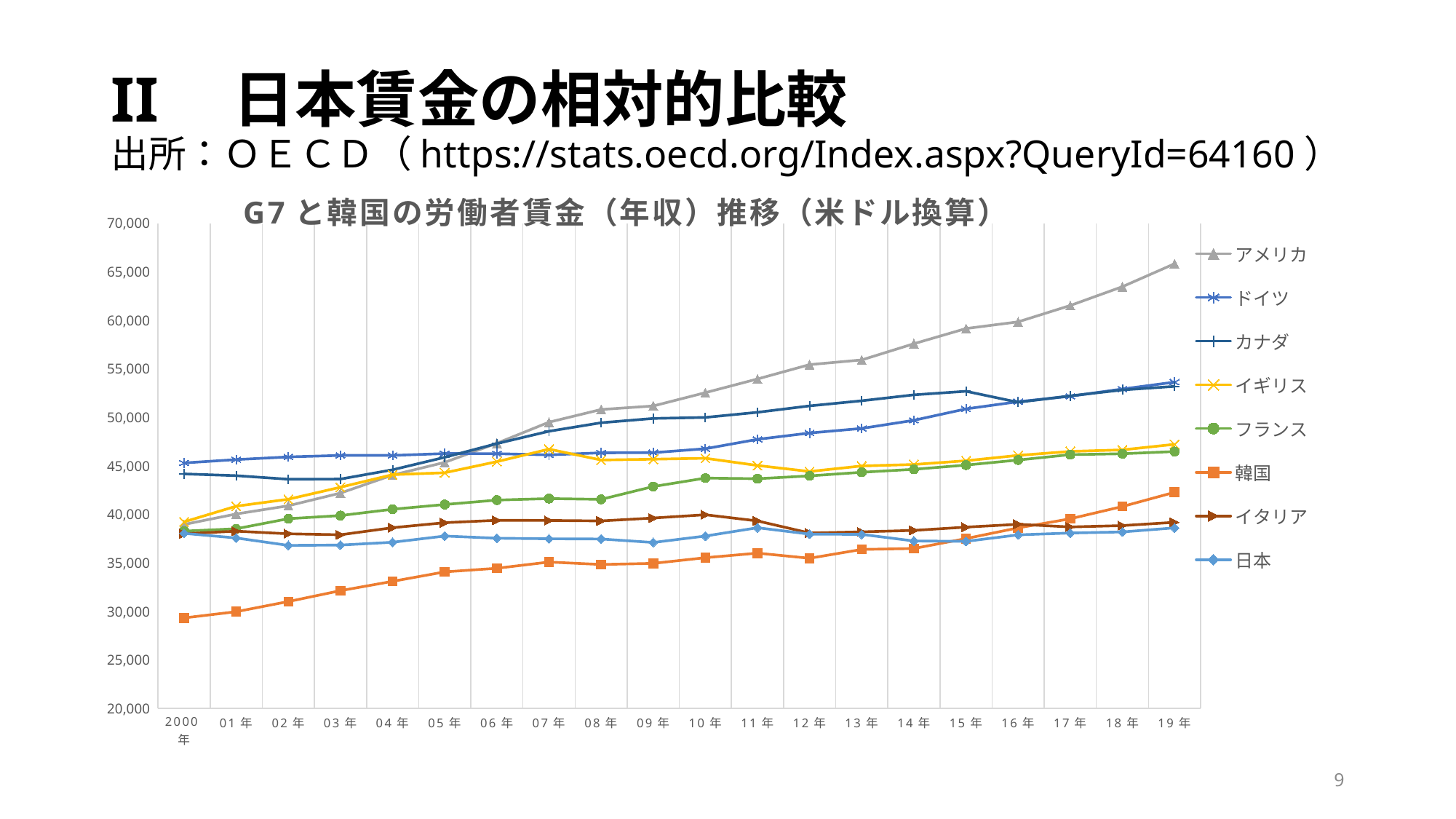
How many years are plotted along the x axis? 20 Is the value for アメリカ in 19年 greater or less than 65,000? greater Does the value for アメリカ rise or fall from 2000年 to 19年? rise Which country has the lowest wage value in 2000年? 韓国 What kind of chart is shown on the slide? line chart Which series is drawn in orange with square markers? 韓国 Which country has the highest wage value in 19年? アメリカ Is the value for 韓国 in 2000年 greater or less than 30,000? less Which is larger in 19年, the value for 韓国 or the value for 日本? 韓国 What is the title of the chart? G7と韓国の労働者賃金（年収）推移（米ドル換算） Is the value for 日本 in 19年 greater or less than 40,000? less How many series does the legend list? 8